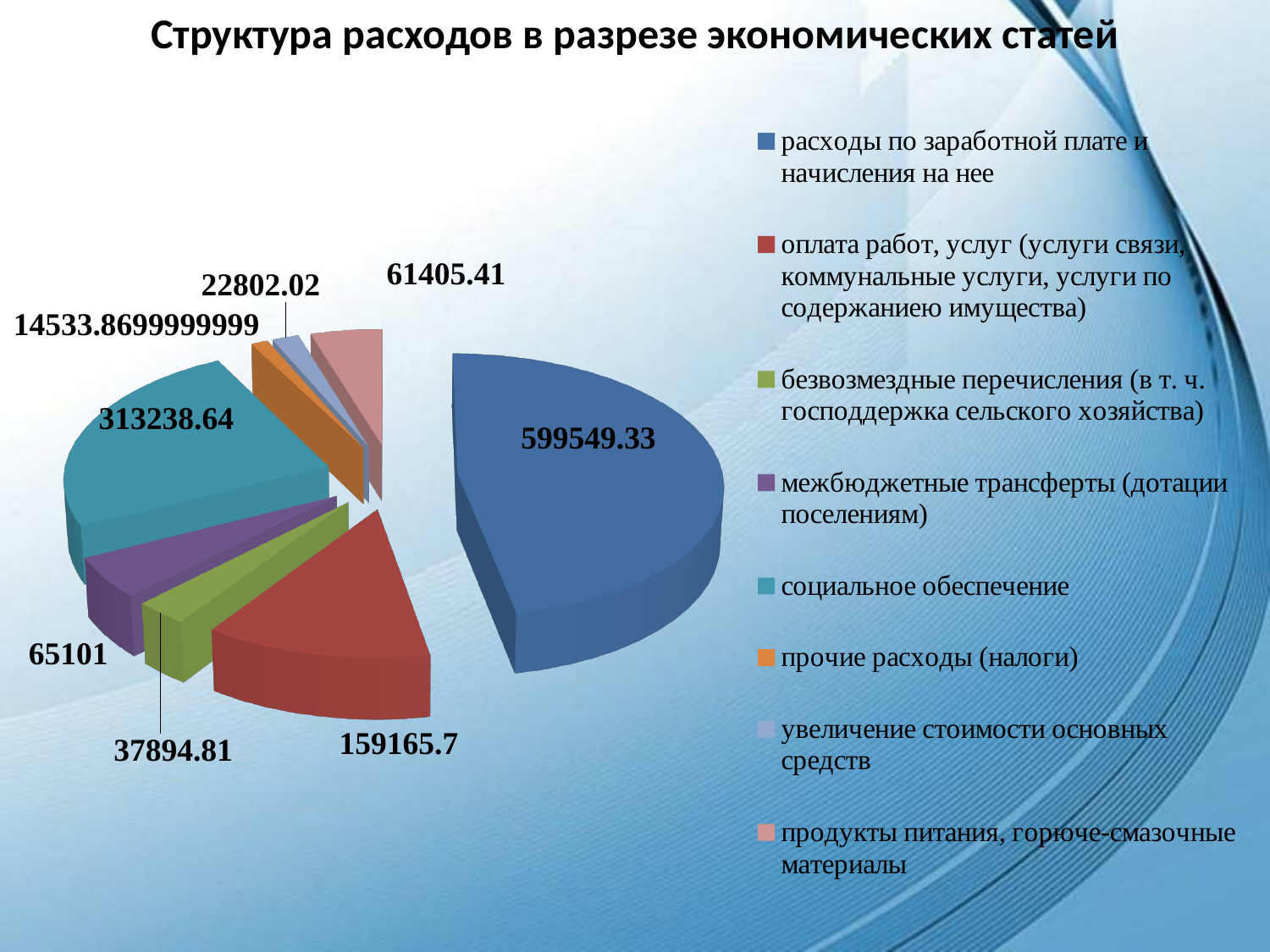
What is the value for 'социальное обеспечение'? 313238.64 What is the title of the slide? Структура расходов в разрезе экономических статей What is the value for 'межбюджетные трансферты (дотации поселениям)'? 65101 Which category has the largest slice? расходы по заработной плате и начисления на нее What type of chart is shown on the slide? pie chart Which is larger: 'оплата работ, услуг' or 'межбюджетные трансферты (дотации поселениям)'? оплата работ, услуг What is the value for 'безвозмездные перечисления (в т. ч. господдержка сельского хозяйства)'? 37894.81 What is the value for 'расходы по заработной плате и начисления на нее'? 599549.33 How many slices does the pie chart have? 8 What is the difference between the values for 'расходы по заработной плате и начисления на нее' and 'социальное обеспечение'? 286310.69 What is the value for 'оплата работ, услуг (услуги связи, коммунальные услуги, услуги по содержанию имущества)'? 159165.7 How many entries does the legend list? 8